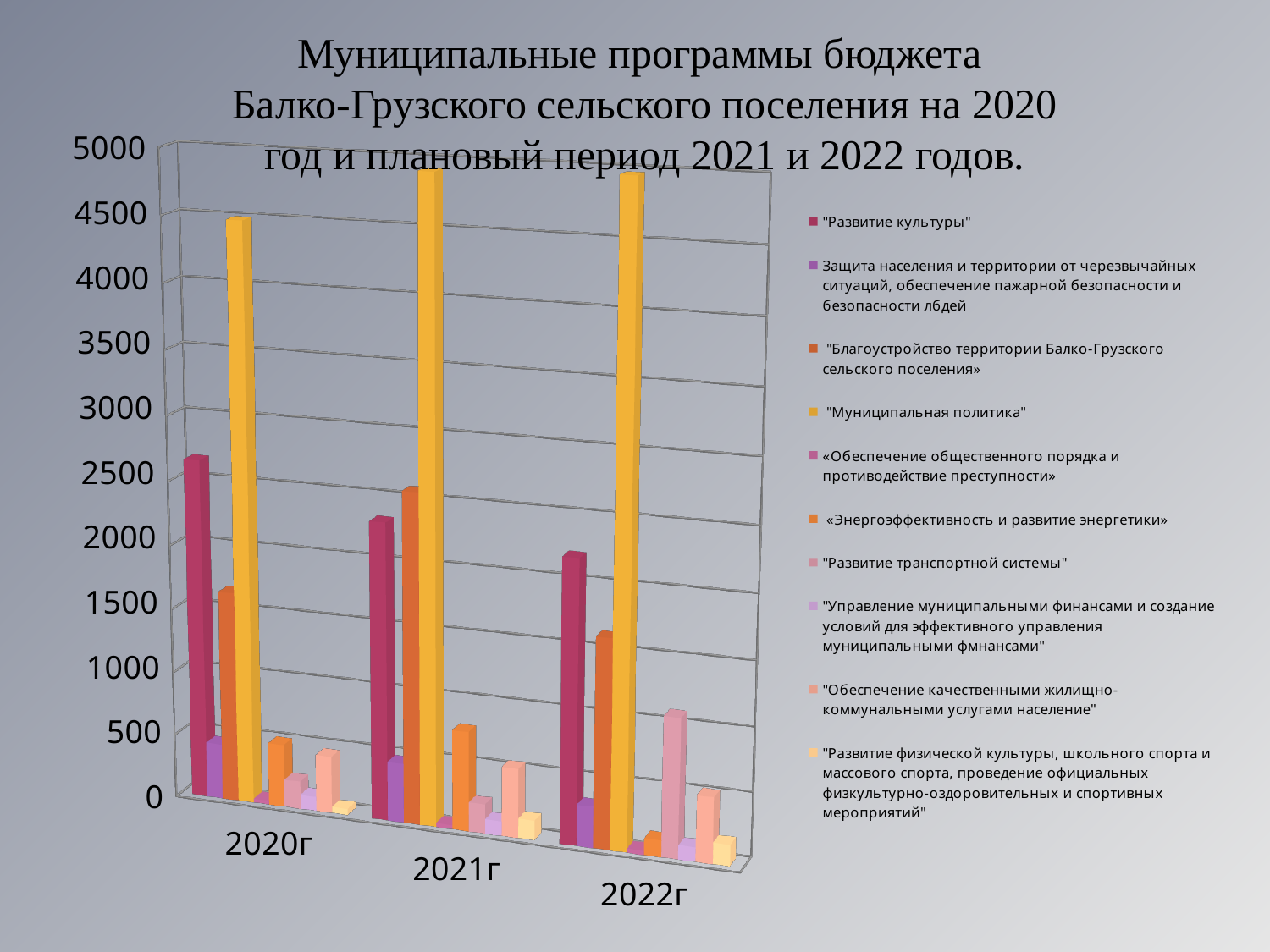
What kind of chart is shown on the slide? bar chart Does the value for "Развитие культуры" rise or fall from 2020г to 2022г? fall How many year categories are shown on the x axis of the chart? 3 Is the value for "Благоустройство территории Балко-Грузского сельского поселения" in 2020г greater or less than 1000? greater Is the value for "Муниципальная политика" in 2020г greater or less than 4000? greater Is the value for "Развитие культуры" in 2020г greater or less than 2000? greater In 2020г, which is larger: "Развитие культуры" or "Благоустройство территории Балко-Грузского сельского поселения"? "Развитие культуры" Which series has the highest value in 2020г? "Муниципальная политика" Does the value for "Развитие транспортной системы" rise or fall from 2020г to 2022г? rise What colour represents "Муниципальная политика" in the chart? yellow How many series does the chart's legend list? 10